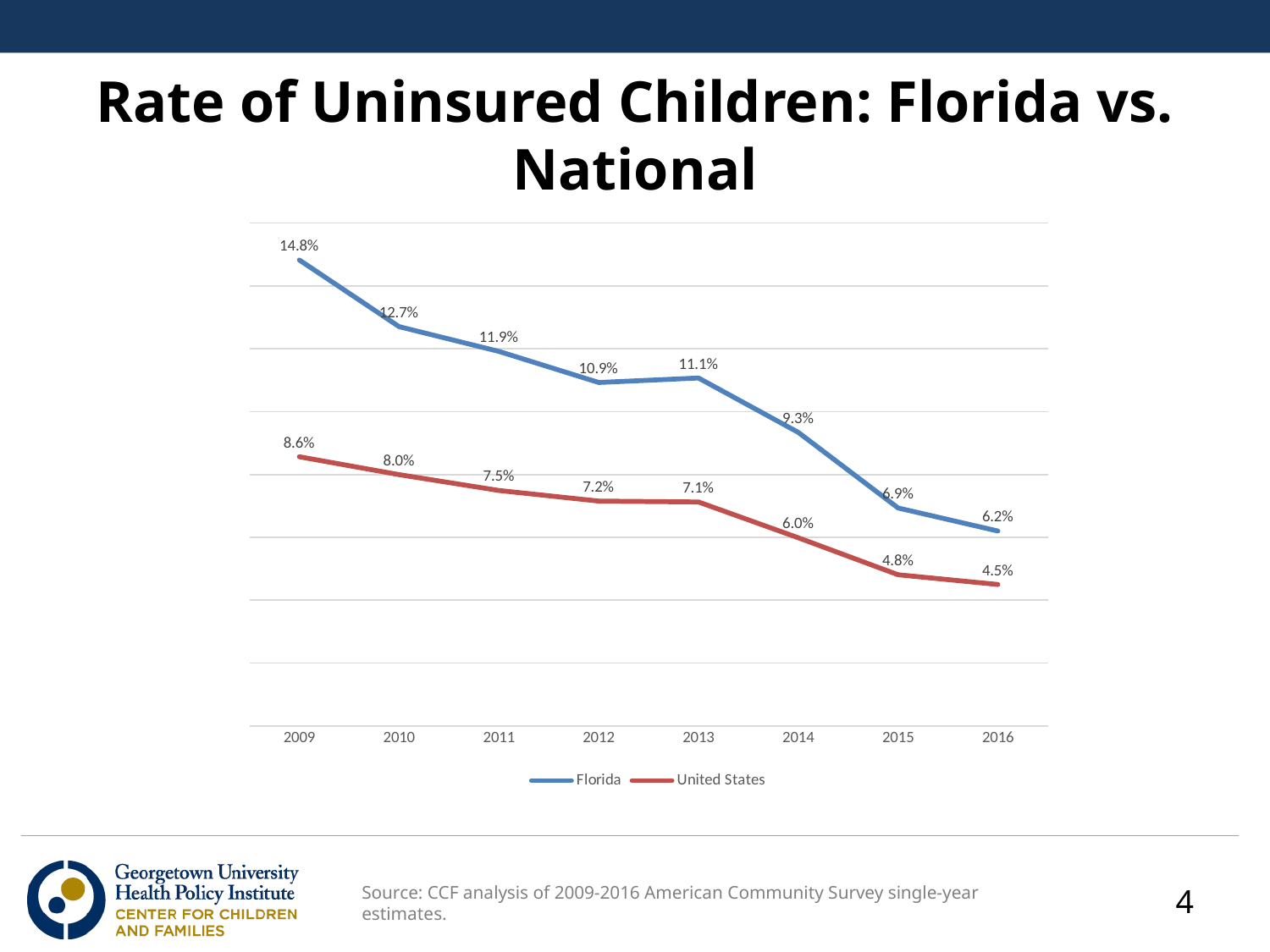
What was the Florida rate of uninsured children in 2014? 9.3% By how much did the Florida rate of uninsured children fall from 2009 to 2016? 8.6% Which had the higher rate of uninsured children in 2013, Florida or the United States? Florida How many series does the chart legend list? 2 In which year was the United States rate of uninsured children lowest? 2016 How many years are shown on the x axis of the chart? 8 In which year was the Florida rate of uninsured children highest? 2009 What was the rate of uninsured children in the United States in 2016? 4.5% What was the United States rate of uninsured children in 2012? 7.2% What was the rate of uninsured children in Florida in 2009? 14.8% What type of chart is shown on the slide? Line chart What is the difference between the Florida and United States rates in 2016? 1.7%